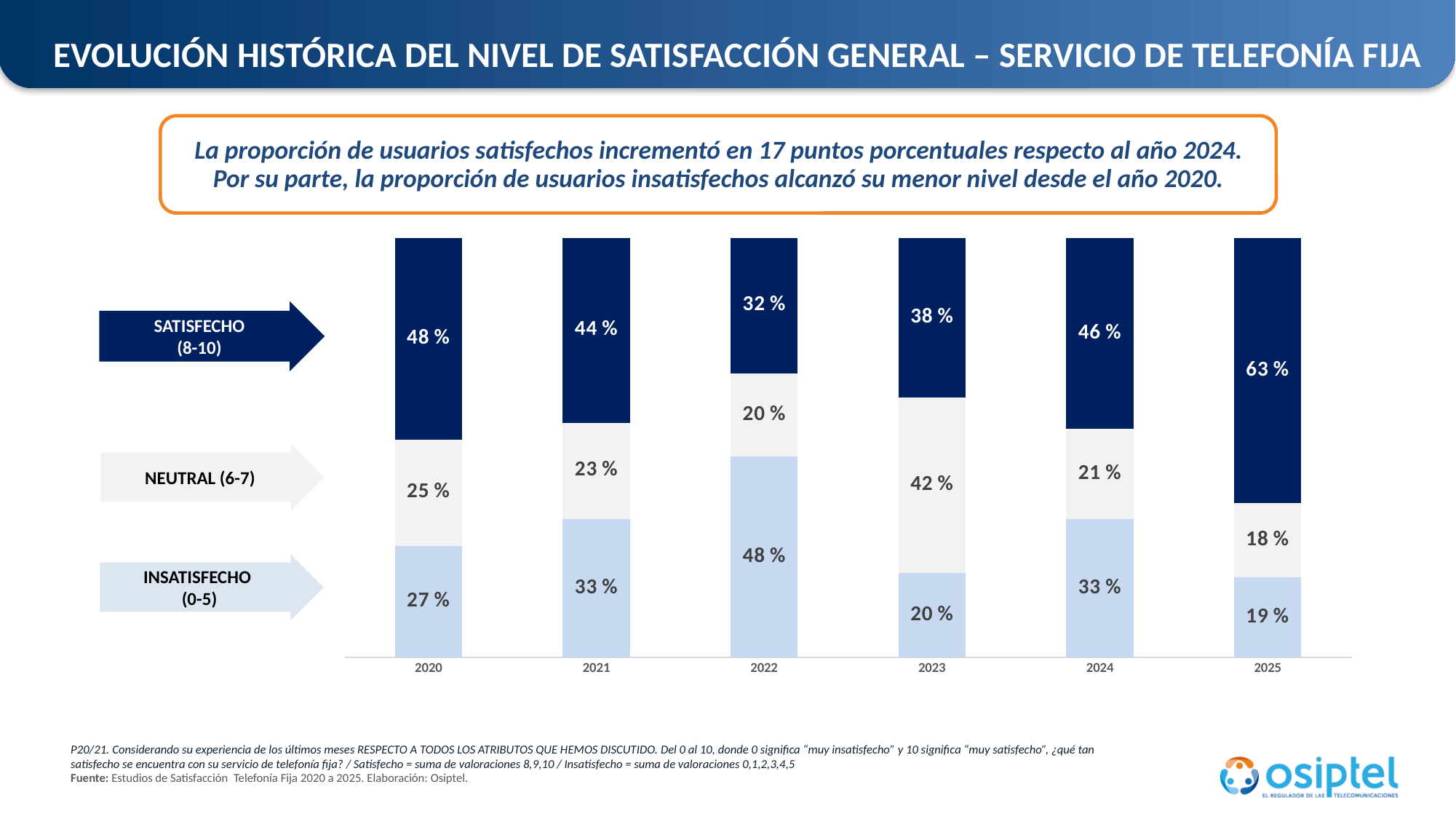
How many years are shown on the x axis of the chart? 6 What kind of chart is shown on the slide? Stacked bar chart What percentage of users were Neutral (6-7) in 2023? 42 % In which year was the Satisfecho (8-10) share highest? 2025 What percentage of users were Insatisfecho (0-5) in 2022? 48 % What is the total of the three segments in the 2023 bar? 100 % How many categories (series) are stacked in each bar? 3 In which year was the Satisfecho (8-10) share lowest? 2022 Which was larger in 2021: the Insatisfecho (0-5) share or the Neutral (6-7) share? Insatisfecho (0-5) By how many percentage points did the Satisfecho (8-10) share change from 2024 to 2025? 17 In which year was the Insatisfecho (0-5) share lowest? 2025 What percentage of users were Satisfecho (8-10) in 2025? 63 %